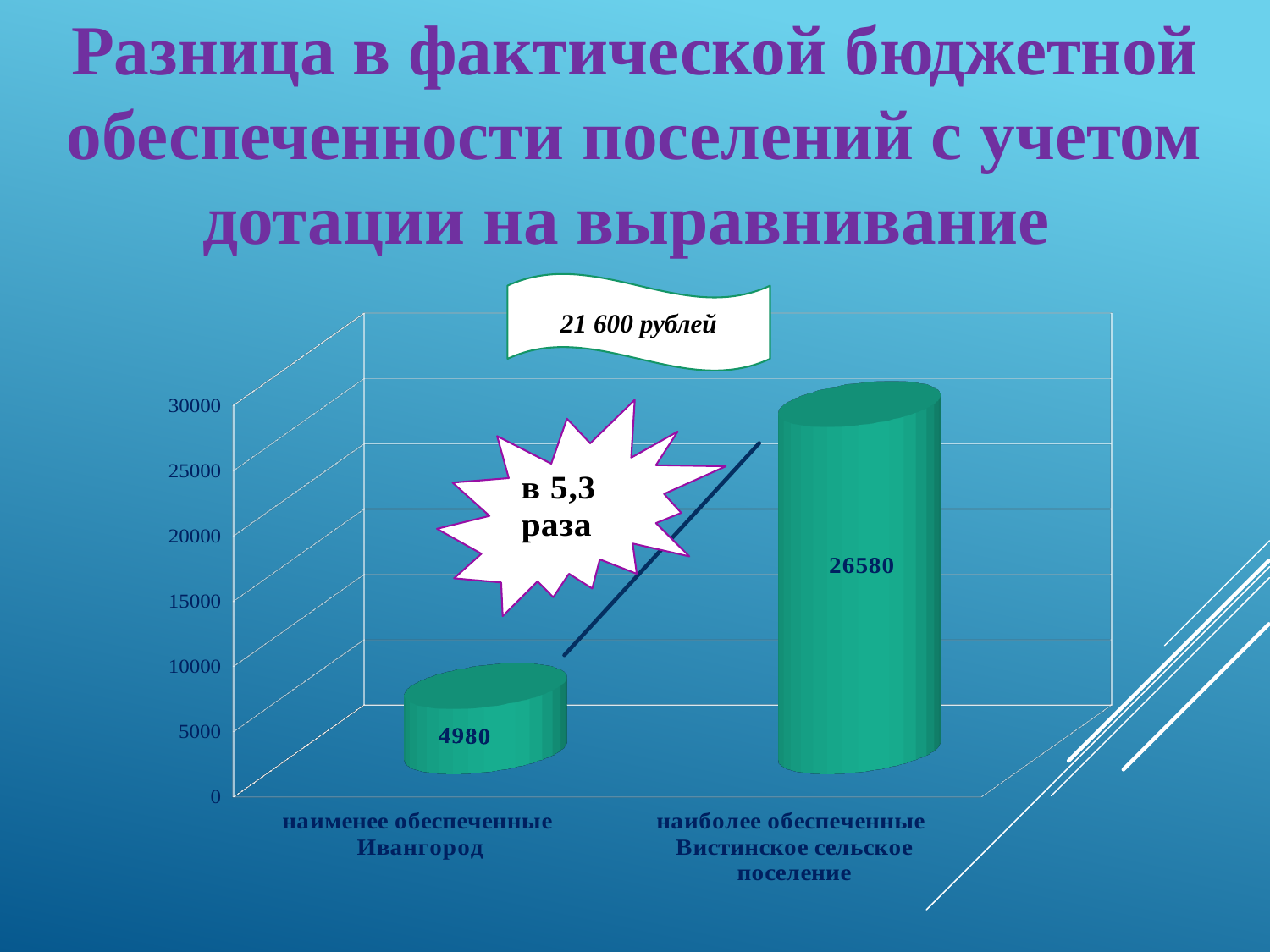
What is the value for наиболее обеспеченные Вистинское сельское поселение? 26580 What is the value for наименее обеспеченные Ивангород? 4980 Is the value for Ивангород greater or less than 10000? less What is the difference between the values for Вистинское сельское поселение and Ивангород? 21600 What is the maximum value shown on the vertical axis? 30000 What kind of chart is shown on the slide? bar chart Which category has the lowest value? наименее обеспеченные Ивангород Which is larger, the value for Ивангород or the value for Вистинское сельское поселение? Вистинское сельское поселение Which category has the highest value? наиболее обеспеченные Вистинское сельское поселение According to the starburst callout, by how many times do the two values differ? в 5,3 раза How many categories are shown in the chart? 2 Is the value for Вистинское сельское поселение greater or less than 25000? greater